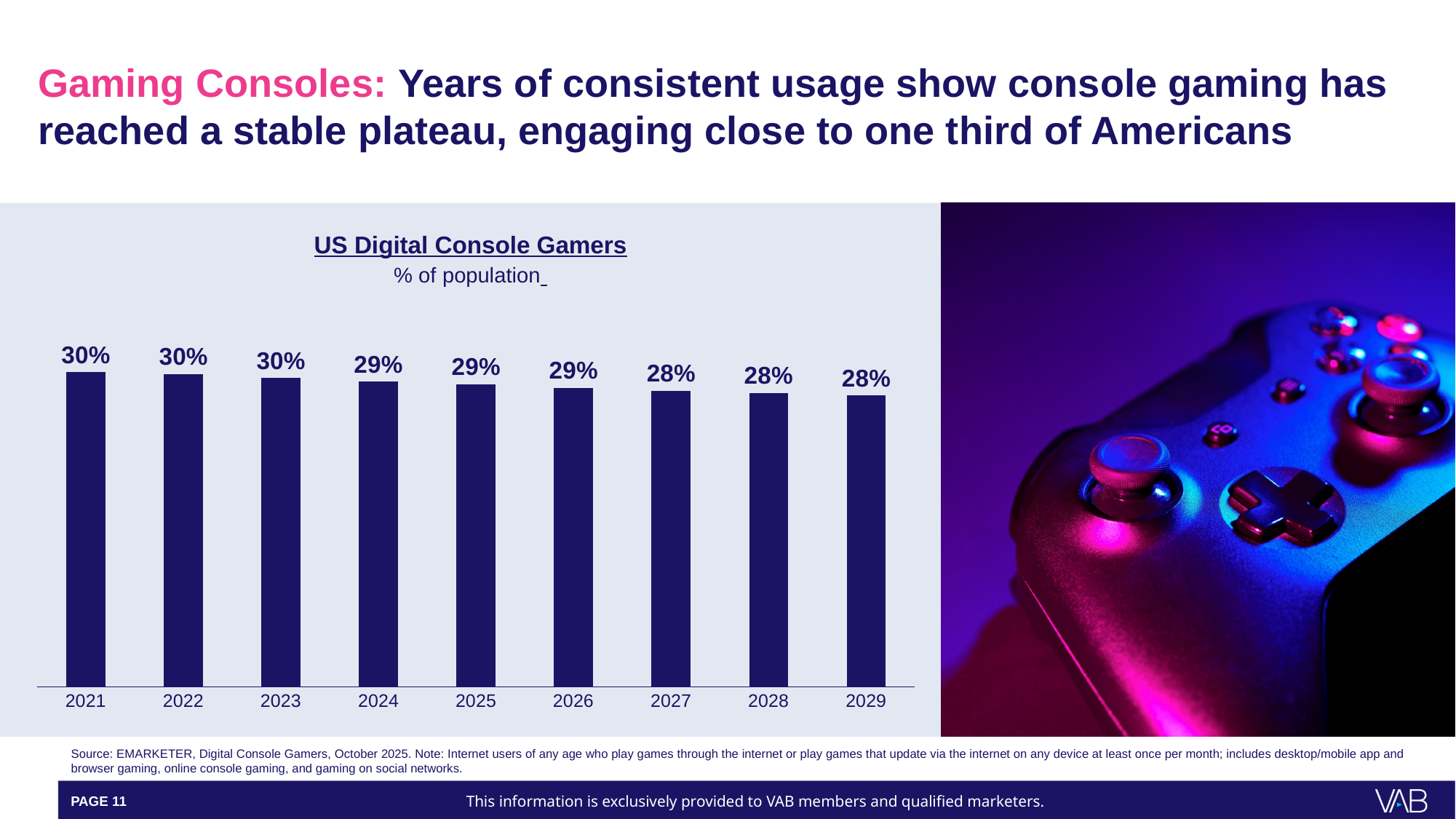
What is the difference between the values for 2023 and 2026? 1% What unit is the chart measured in, according to its subtitle? % of population What is the value for 2029? 28% What is the value for 2025? 29% Do the values rise or fall from 2021 to 2029? fall What is the value for 2024? 29% What is the title of the chart? US Digital Console Gamers What is the difference between the values for 2021 and 2029? 2% What is the value for 2021? 30% Which is larger, the value for 2022 or the value for 2028? 2022 How many years are shown on the x axis? 9 What kind of chart is shown on the slide? bar chart